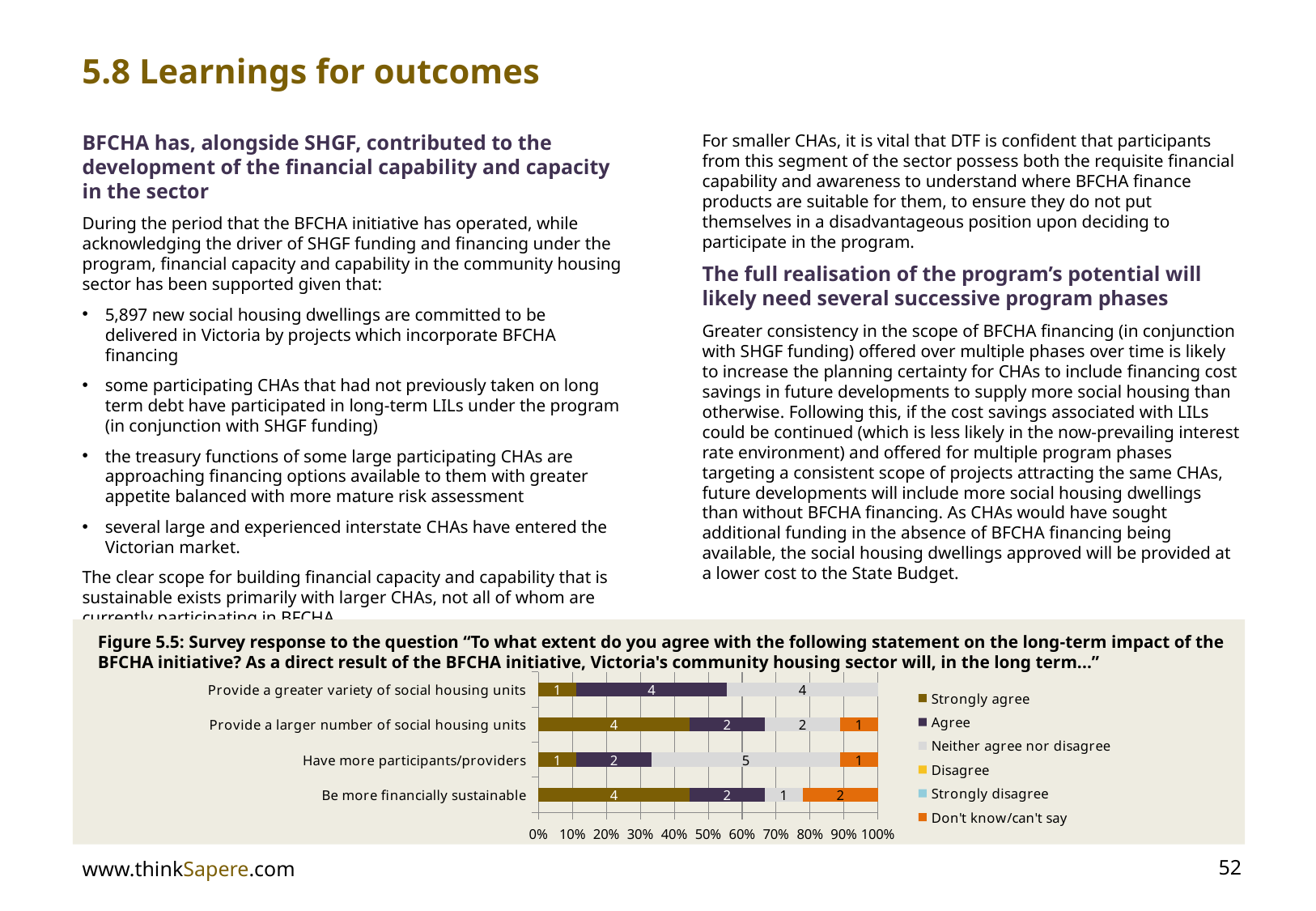
How many response options does the legend of Figure 5.5 list? 6 In Figure 5.5, how many respondents answered 'Don't know/can't say' for 'Be more financially sustainable'? 2 In Figure 5.5, how many respondents answered 'Strongly agree' for 'Provide a larger number of social housing units'? 4 What kind of chart is shown in Figure 5.5? Stacked bar chart In Figure 5.5, how many respondents answered 'Agree' for 'Provide a greater variety of social housing units'? 4 In Figure 5.5, which is larger: the 'Agree' count for 'Provide a greater variety of social housing units' or the 'Agree' count for 'Be more financially sustainable'? Provide a greater variety of social housing units In Figure 5.5, what is the total number of responses shown in the bar for 'Provide a larger number of social housing units'? 9 In Figure 5.5, which statement has the highest 'Neither agree nor disagree' count? Have more participants/providers In Figure 5.5, what colour represents 'Strongly agree' in the legend? Brown/olive In Figure 5.5, what is the difference between the 'Strongly agree' counts for 'Be more financially sustainable' and 'Have more participants/providers'? 3 In Figure 5.5, how many respondents answered 'Neither agree nor disagree' for 'Have more participants/providers'? 5 How many statements (categories) are plotted in Figure 5.5? 4